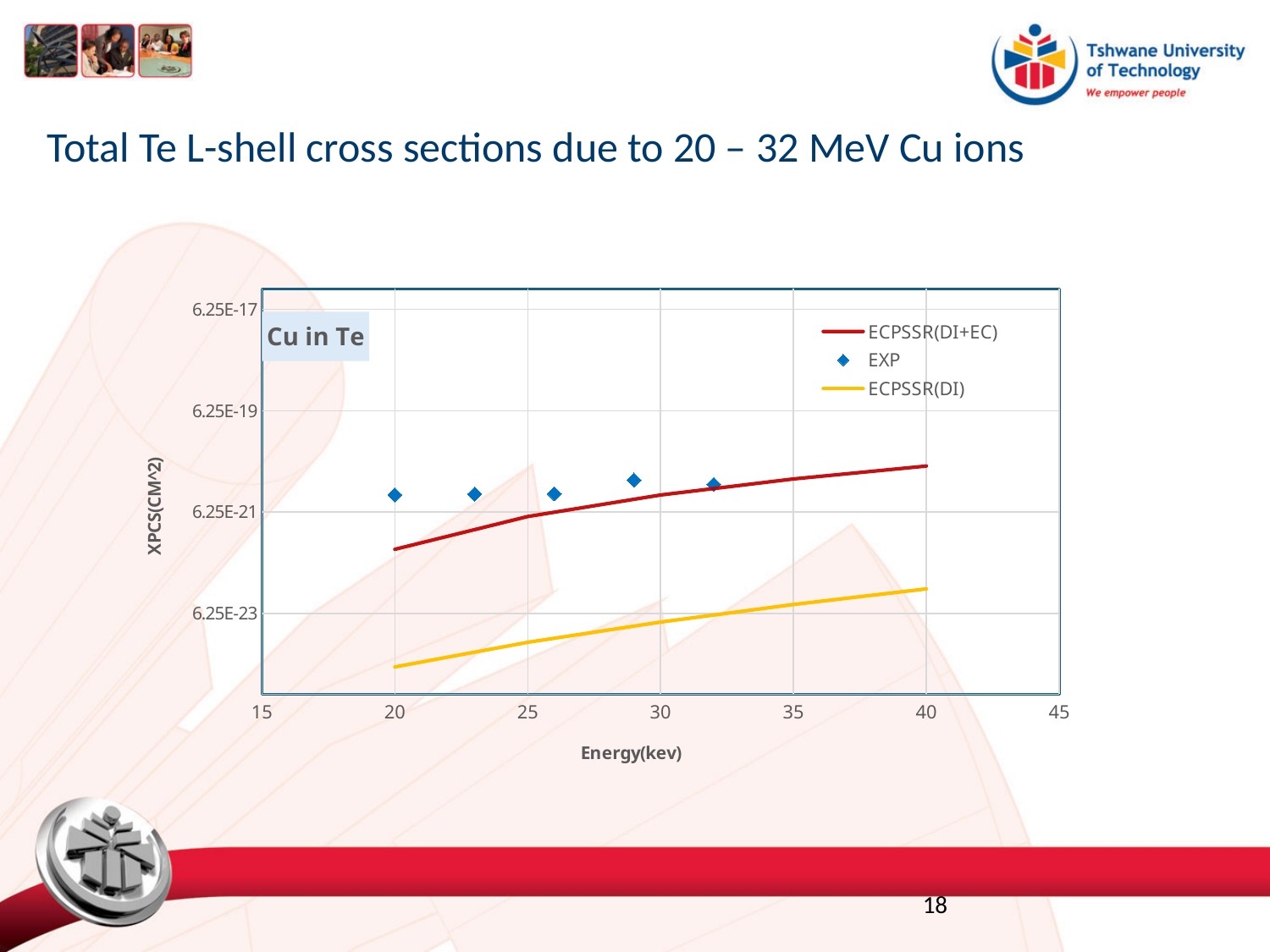
Is the EXP value at 20 keV greater or less than 6.25E-21? greater Does the ECPSSR(DI+EC) curve rise or fall as energy increases? rise How many series does the legend list? 3 What is the label on the x axis? Energy(kev) Is the ECPSSR(DI+EC) value at 40 keV greater or less than 6.25E-21? greater Is the ECPSSR(DI+EC) value at 20 keV greater or less than 6.25E-21? less Which series has the lowest values across the energy range? ECPSSR(DI) What kind of chart is shown on the slide? line chart At 20 keV, which is larger: the EXP value or the ECPSSR(DI+EC) value? EXP How many EXP data points are plotted? 5